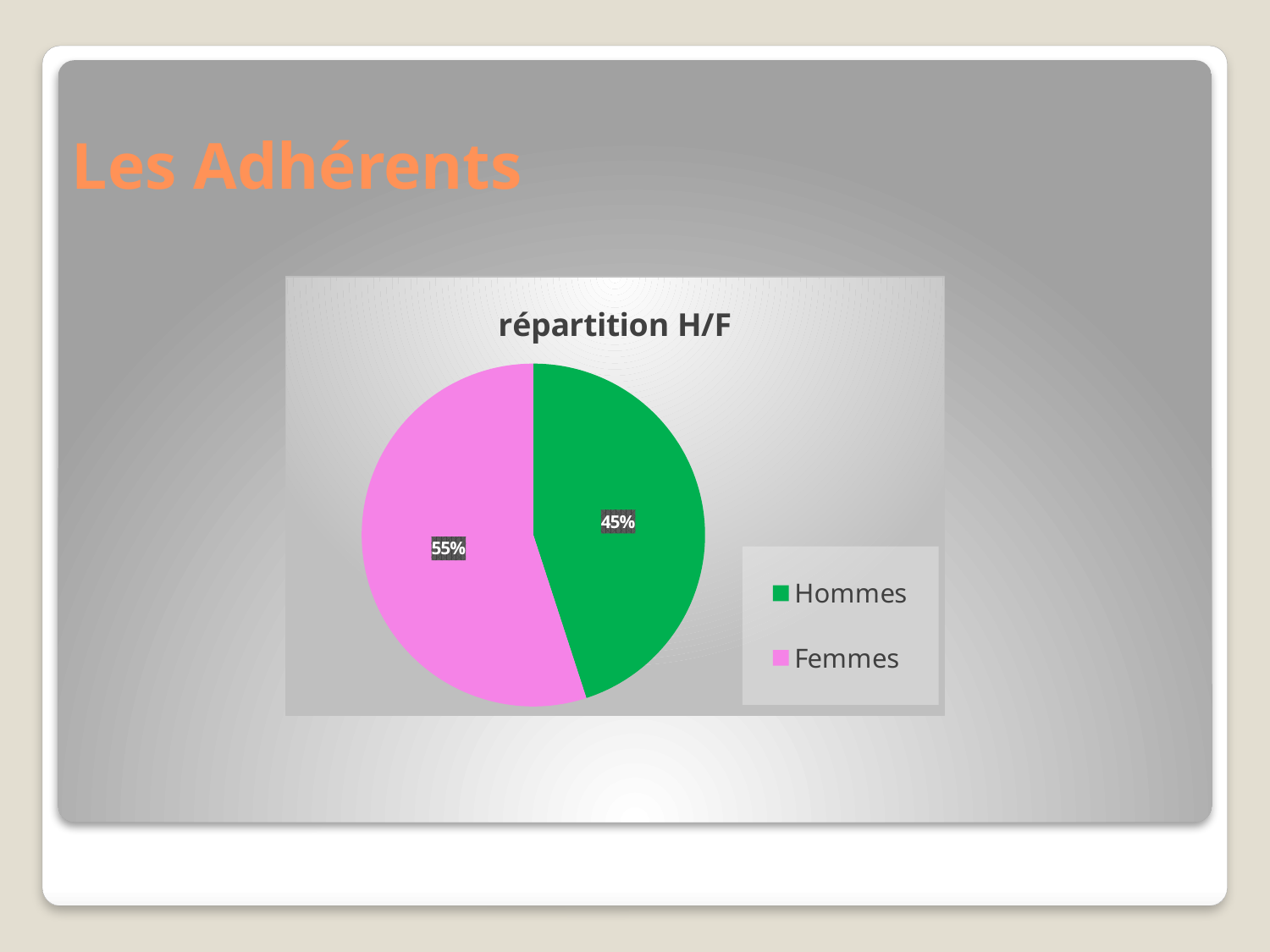
What share of the pie is Hommes? 45% Which is larger, the Hommes slice or the Femmes slice? Femmes What colour is the Femmes slice? pink What type of chart is shown on the slide? pie chart How many slices does the pie chart have? 2 How many entries does the legend list? 2 Which slice is the smallest? Hommes What is the title of the chart? répartition H/F What share of the pie is Femmes? 55% Which slice is the largest? Femmes Is the Hommes share greater or less than 50%? less What is the difference between the Femmes share and the Hommes share? 10%